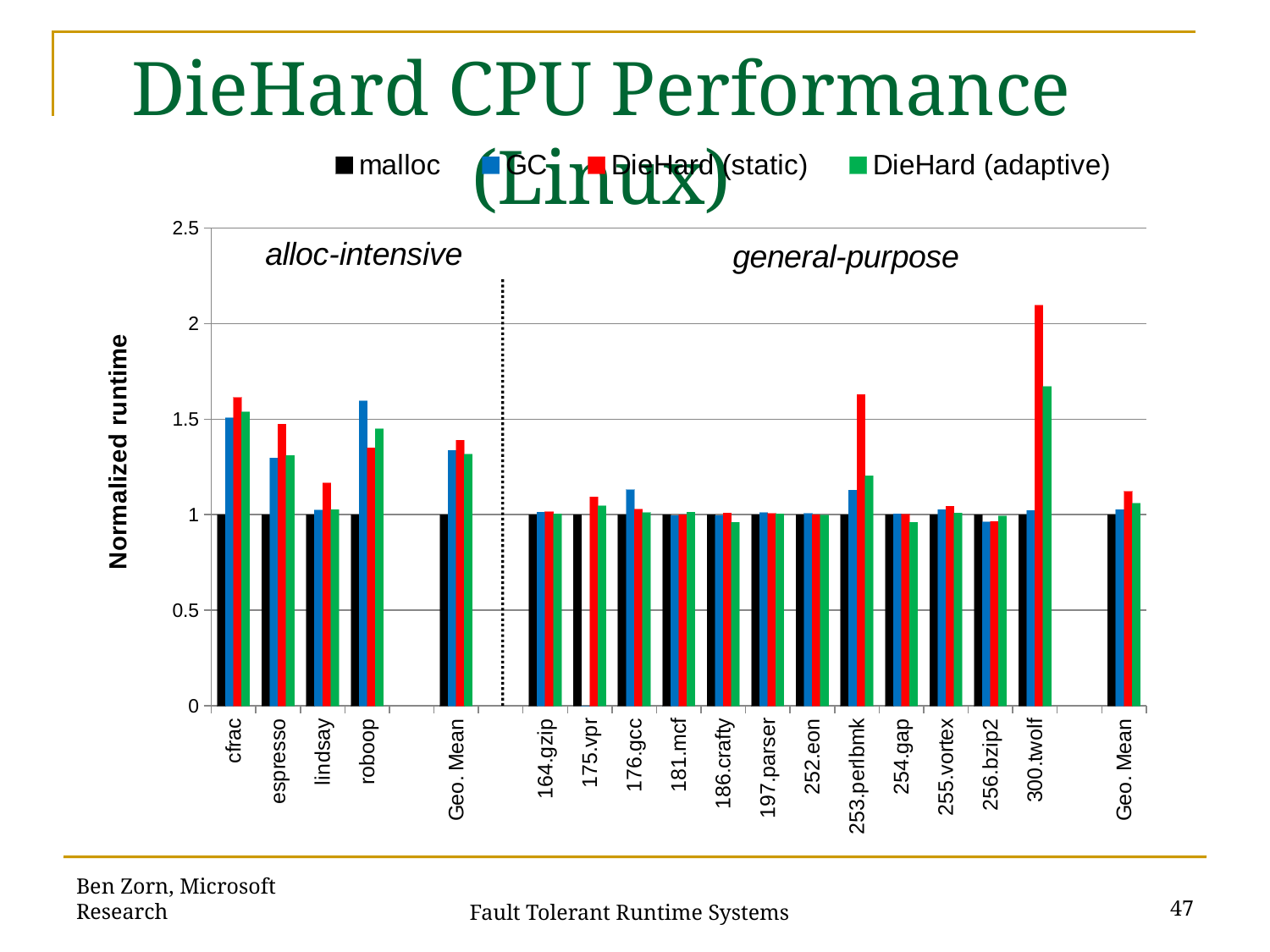
Which category has the highest DieHard (static) value? 300.twolf Which is larger: the DieHard (static) value for 300.twolf or for 253.perlbmk? 300.twolf What kind of chart is shown on the slide? bar chart Is the DieHard (static) value for lindsay greater or less than 1.5? less How many series does the legend list? 4 What is the malloc value for cfrac? 1 What are the two group labels written above the bars? alloc-intensive and general-purpose Which category has the highest GC value? roboop How many categories are shown along the x axis? 18 What is the label on the y axis? Normalized runtime Is the DieHard (static) value for 253.perlbmk greater or less than 1.5? greater Is the DieHard (static) value for 300.twolf greater or less than 2? greater